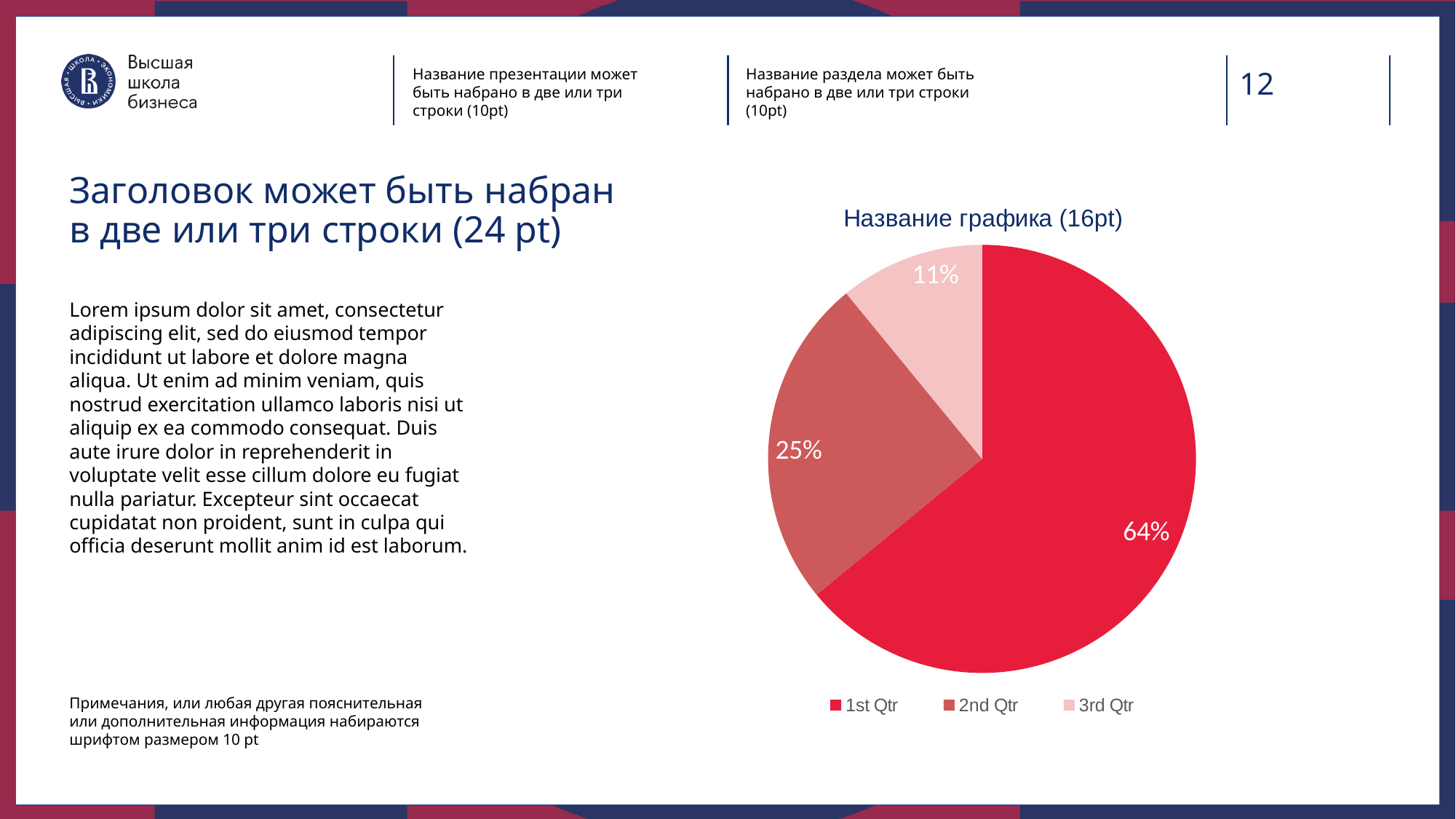
Which slice is the smallest? 3rd Qtr What is the difference in percentage points between the 1st Qtr and 2nd Qtr slices? 39 What share of the pie does 2nd Qtr take? 25% Which slice is the largest? 1st Qtr How many slices does the pie chart have? 3 What is the difference in percentage points between the 2nd Qtr and 3rd Qtr slices? 14 What is the chart's title? Название графика (16pt) How many entries does the legend list? 3 What share of the pie does 1st Qtr take? 64% Which is larger, the 2nd Qtr slice or the 3rd Qtr slice? 2nd Qtr What share of the pie does 3rd Qtr take? 11% What kind of chart is shown on the slide? pie chart